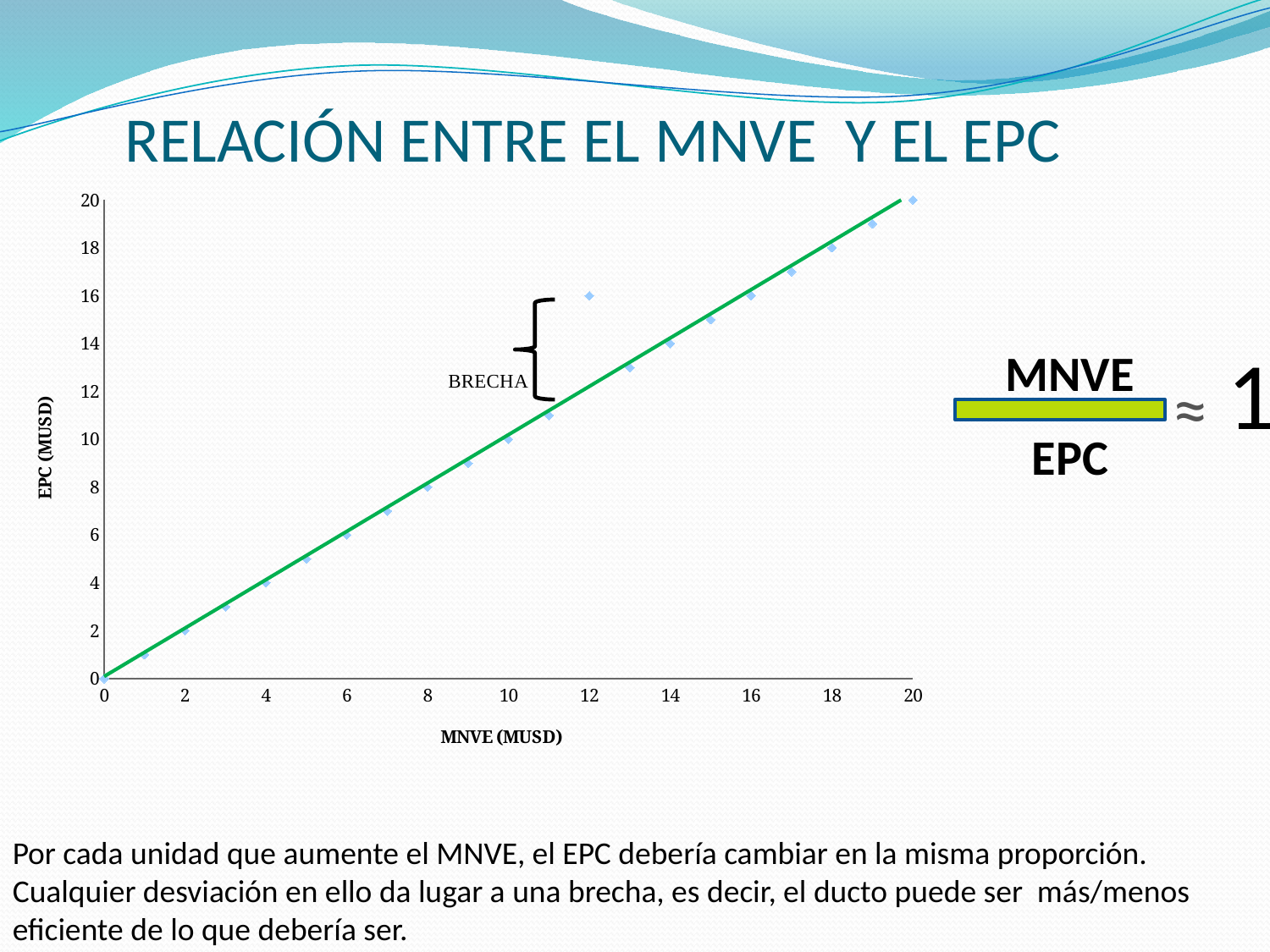
Which point has the lowest EPC (MUSD) value? MNVE = 0 What is the EPC (MUSD) value of the point at MNVE = 12? 16 Which has a larger EPC value, the point at MNVE = 12 or the point at MNVE = 14? MNVE = 12 Do the EPC values rise or fall as MNVE increases along the x axis? Rise What is the label of the y axis of the chart? EPC (MUSD) At which MNVE value does the plotted point lie farthest above the green line (the point marked BRECHA)? 12 What is the EPC (MUSD) value of the point at MNVE = 10? 10 Is the EPC value of the point at MNVE = 12 greater or less than 14? greater What is the label of the x axis of the chart? MNVE (MUSD) What is the EPC (MUSD) value of the point at MNVE = 20? 20 Which point has the highest EPC (MUSD) value? MNVE = 20 What kind of chart is shown on the slide? Scatter chart